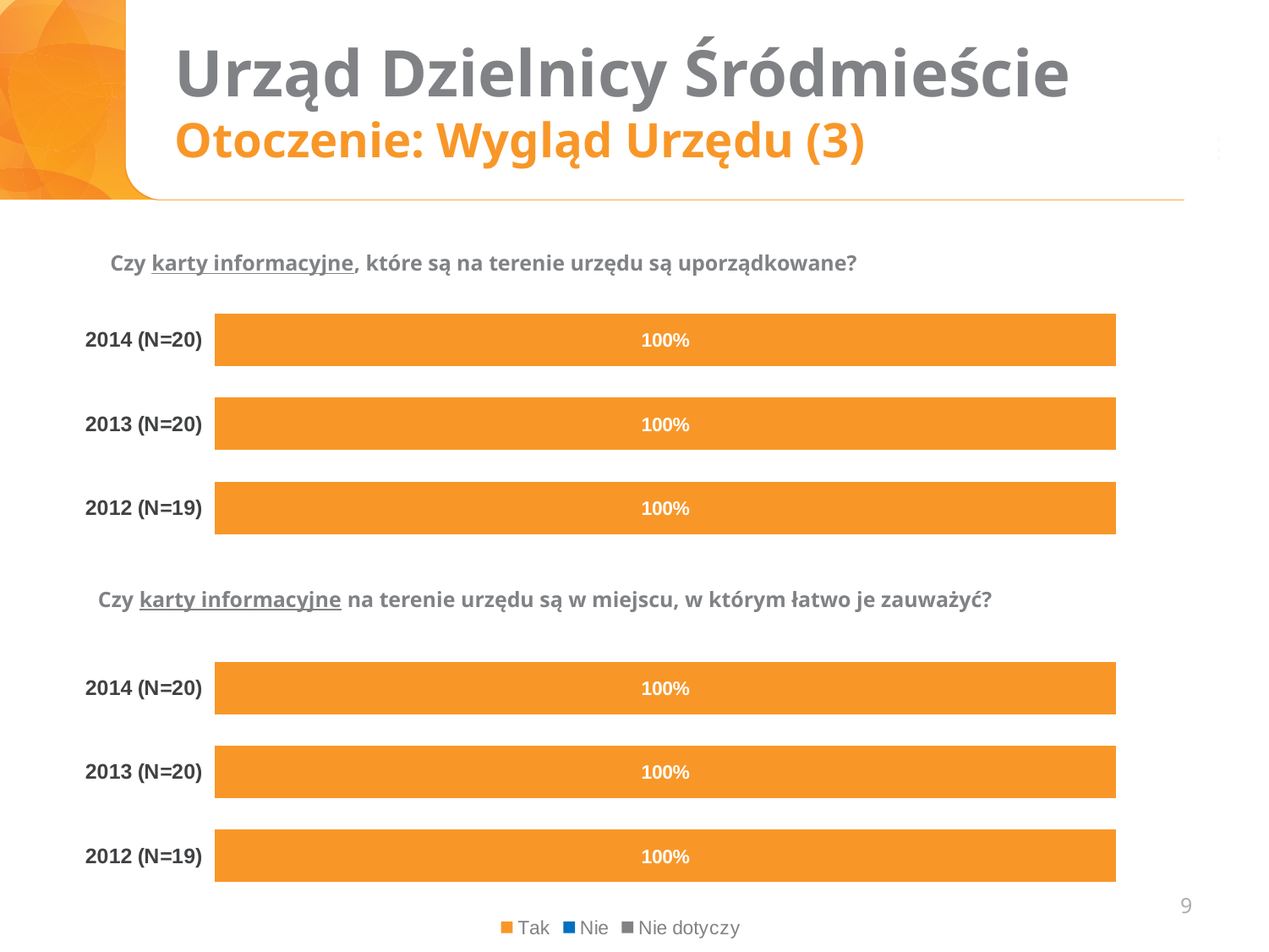
In the bottom chart, what is the value shown for 2014 (N=20)? 100% What is the sample size (N) shown for 2012 in the bottom chart? N=19 In the top chart, what is the difference between the values for 2014 (N=20) and 2012 (N=19)? 0% Which series does the orange colour represent in the legend? Tak How many series does the legend at the bottom of the slide list? 3 In the bottom chart ("Czy karty informacyjne na terenie urzędu są w miejscu, w którym łatwo je zauważyć?"), what is the value for 2013 (N=20)? 100% How many categories (years) are shown in the top chart? 3 What kind of chart is the top chart? Bar chart How many categories (years) are shown in the bottom chart? 3 In the top chart, what is the value shown for 2012 (N=19)? 100% In the bottom chart, is the value for 2013 (N=20) greater than, less than, or equal to the value for 2012 (N=19)? Equal In the top chart ("Czy karty informacyjne, które są na terenie urzędu są uporządkowane?"), what is the value for 2014 (N=20)? 100%